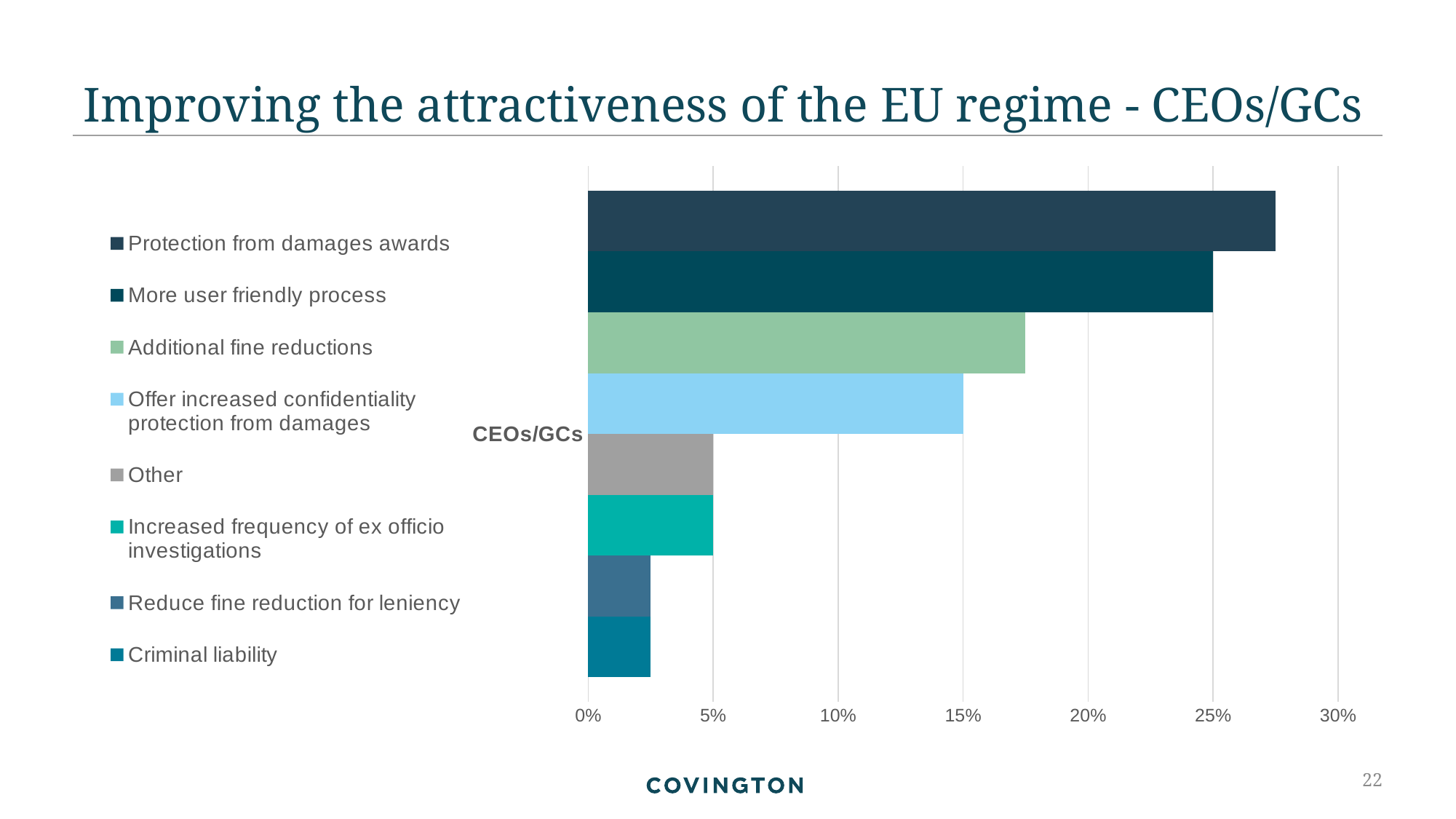
Is the value for Criminal liability greater or less than 5%? less What is the difference between More user friendly process and Offer increased confidentiality protection from damages? 10% How many series does the legend list? 8 What is the value for More user friendly process? 25% Which series has the highest value? Protection from damages awards What is the category label shown on the vertical axis of the chart? CEOs/GCs What is the value for Other? 5% Is the value for Additional fine reductions greater or less than 15%? greater What is the value for Offer increased confidentiality protection from damages? 15% What type of chart is shown on the slide? bar chart What is the value for Increased frequency of ex officio investigations? 5% Which is larger, Protection from damages awards or More user friendly process? Protection from damages awards